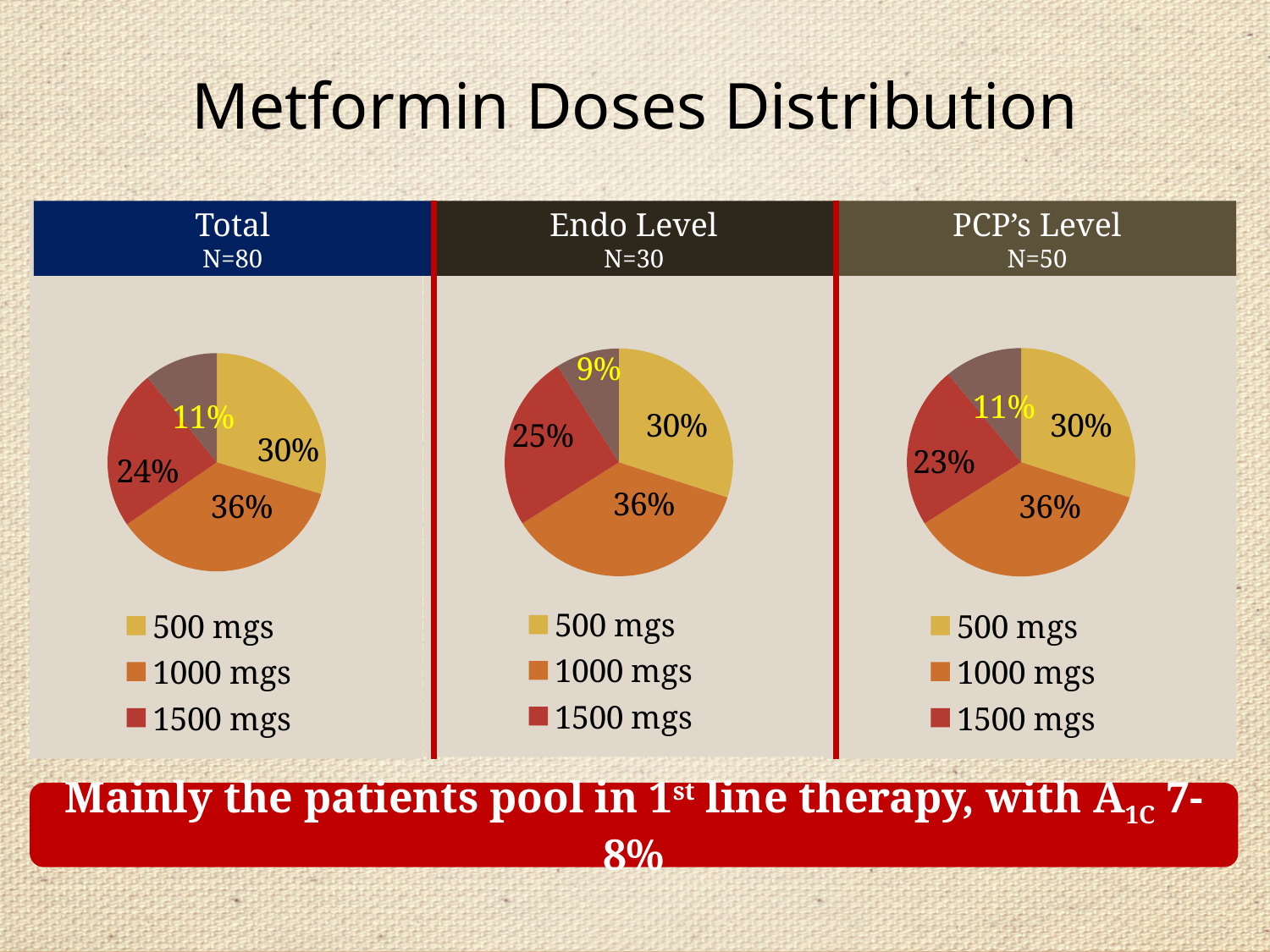
What kind of chart is used for the Total, Endo Level and PCP's Level panels? Pie chart In the PCP's Level pie chart, what share of patients received 500 mgs? 30% In the PCP's Level pie chart, what share of patients received 1500 mgs? 23% What is the sample size (N) shown for the PCP's Level pie chart? N=50 In the Total pie chart, what share of patients received 1000 mgs? 36% In the Total pie chart, what is the difference between the 1000 mgs share and the 1500 mgs share? 12% In the PCP's Level pie chart, what is the difference between the 500 mgs share and the 1500 mgs share? 7% In the Total pie chart, which dose has the largest share? 1000 mgs How many entries does the legend of the Endo Level pie chart list? 3 In the Endo Level pie chart, which dose has the largest share? 1000 mgs In the Endo Level pie chart, what share of patients received 1500 mgs? 25% In the Endo Level pie chart, which is larger, the 500 mgs share or the 1500 mgs share? 500 mgs